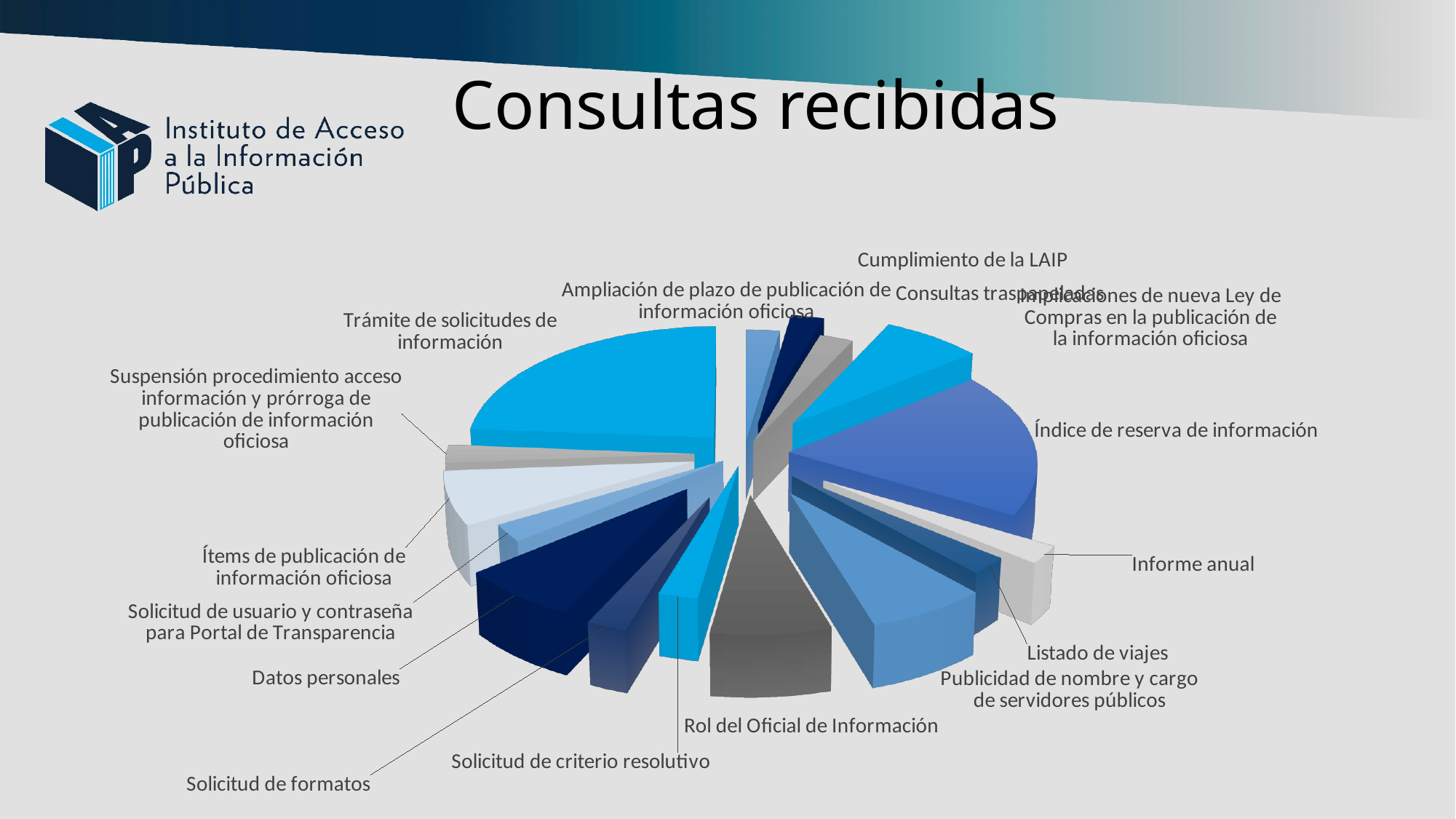
Which is larger in the pie chart: the slice for Rol del Oficial de Información or the slice for Consultas traspapeladas? Rol del Oficial de Información Which is larger in the pie chart: the slice for Publicidad de nombre y cargo de servidores públicos or the slice for Listado de viajes? Publicidad de nombre y cargo de servidores públicos Which is larger in the pie chart: the slice for Datos personales or the slice for Informe anual? Datos personales How many labeled categories does the pie chart have? 16 What is the title of the chart on the slide? Consultas recibidas What kind of chart is shown on the slide? Pie chart Does the pie chart display numeric data labels on its slices? No